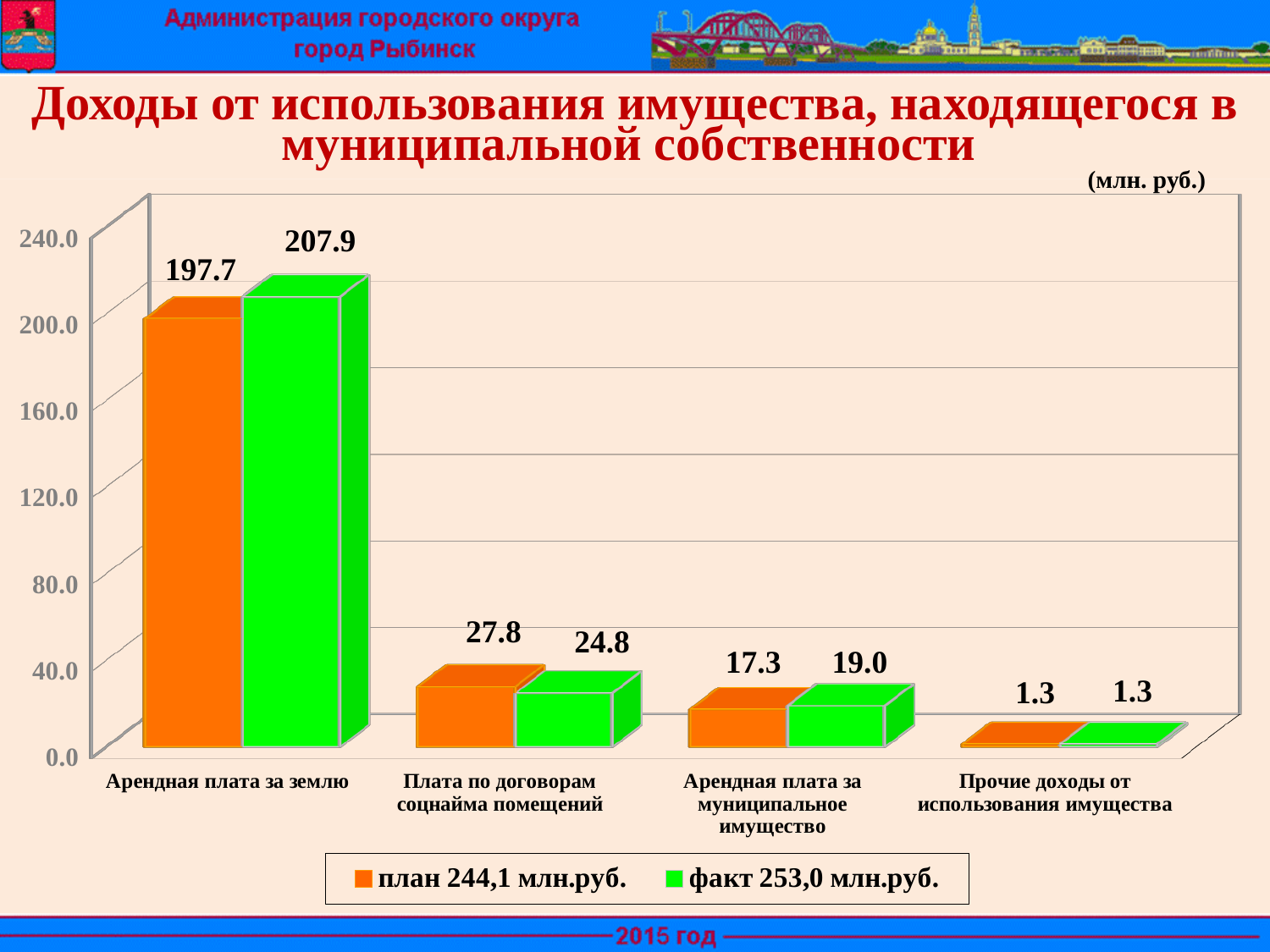
What is the difference between the факт and план values for Арендная плата за землю? 10.2 What is the факт value for Плата по договорам соцнайма помещений? 24.8 Which category has the highest факт value? Арендная плата за землю What is the план value for Арендная плата за муниципальное имущество? 17.3 How many categories are shown on the x axis? 4 What is the факт value for Арендная плата за землю? 207.9 Is the факт value for Арендная плата за землю greater or less than 200.0? greater What kind of chart is shown on the slide? bar chart How many series does the legend list? 2 What is the план value for Арендная плата за землю? 197.7 Which category has the lowest план value? Прочие доходы от использования имущества For Плата по договорам соцнайма помещений, which is larger: план or факт? план